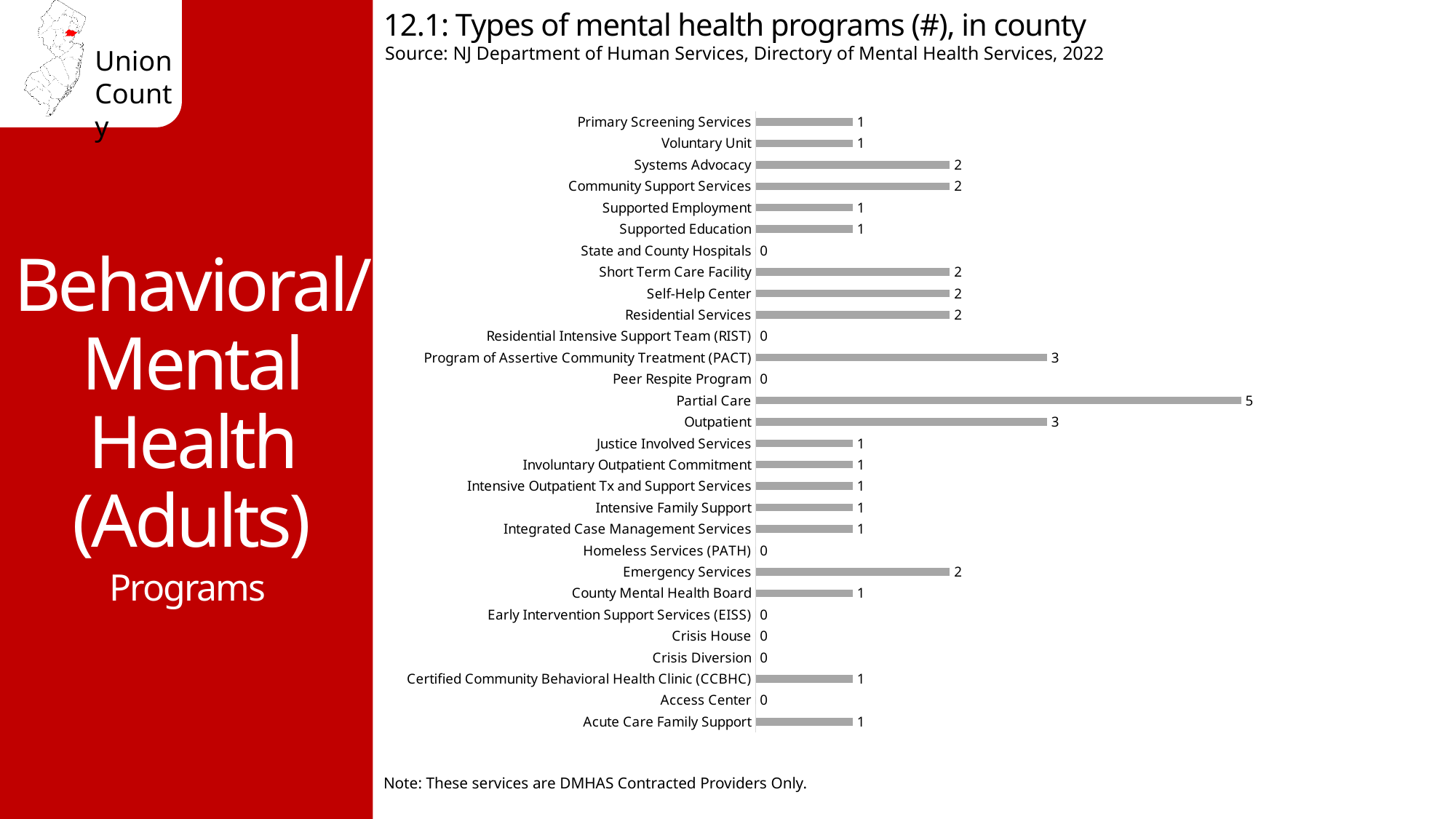
How many categories have a value of 0? 8 How many categories are plotted on the chart? 29 What is the title of the chart? 12.1: Types of mental health programs (#), in county What is the value for Emergency Services? 2 What is the source cited for the chart? NJ Department of Human Services, Directory of Mental Health Services, 2022 How many programs are shown for Program of Assertive Community Treatment (PACT)? 3 Which category has the highest value? Partial Care Which is larger, the value for Systems Advocacy or the value for Voluntary Unit? Systems Advocacy What is the difference between the values for Partial Care and Outpatient? 2 What kind of chart is shown on the slide? Bar chart What is the value for Crisis House? 0 What is the value for Partial Care? 5